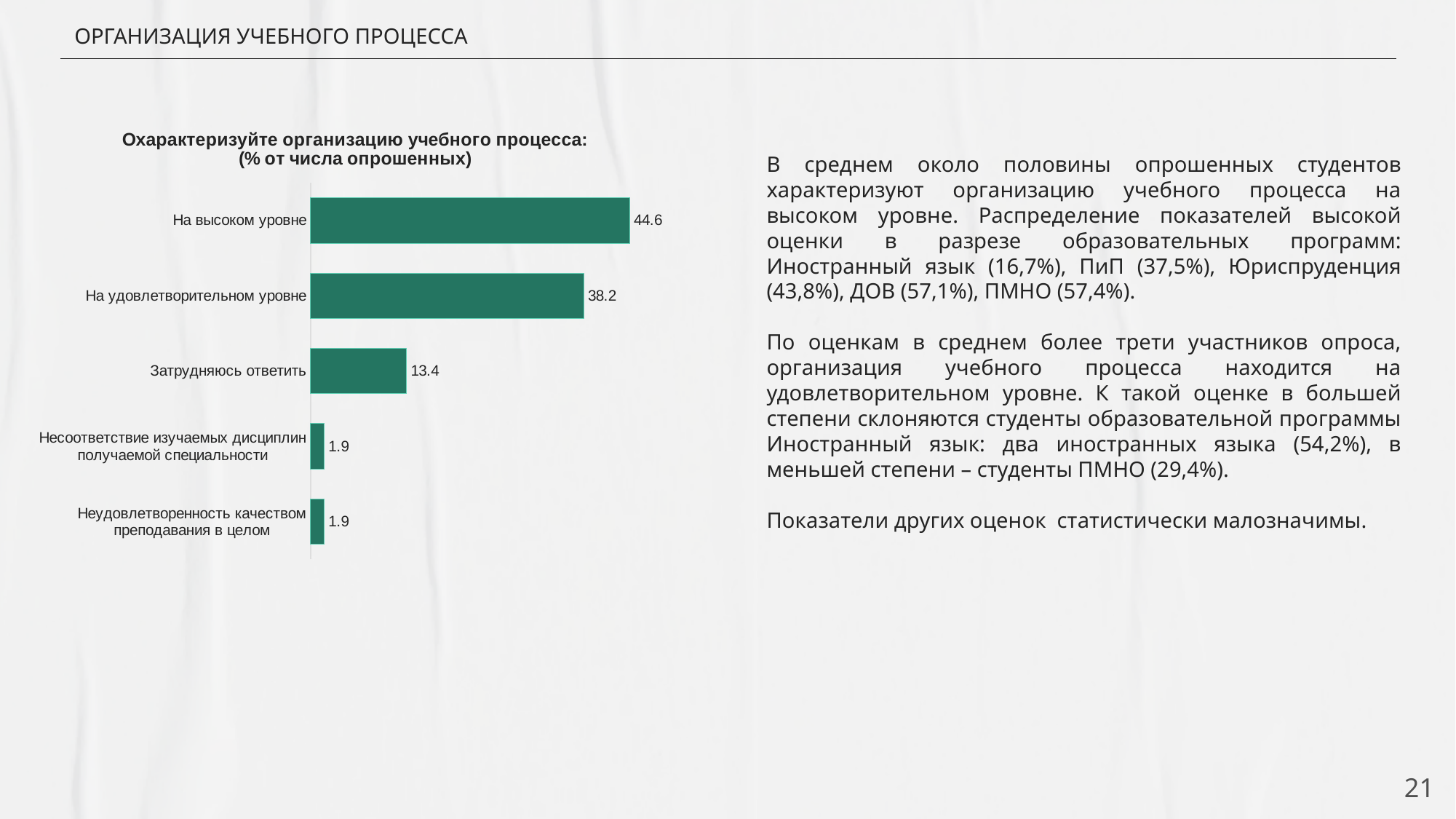
Which is larger: the value for "Затрудняюсь ответить" or the value for "Неудовлетворенность качеством преподавания в целом"? Затрудняюсь ответить What is the difference between the values for "На высоком уровне" and "На удовлетворительном уровне"? 6.4 How many categories are shown in the chart? 5 What is the value for "Несоответствие изучаемых дисциплин получаемой специальности"? 1.9 What is the value for "На удовлетворительном уровне"? 38.2 What is the value for "Затрудняюсь ответить"? 13.4 Which category has the highest value? На высоком уровне What colour are the bars in the chart? Green What is the difference between the values for "На удовлетворительном уровне" and "Затрудняюсь ответить"? 24.8 What is the value for "На высоком уровне"? 44.6 What kind of chart is shown on the slide? Bar chart What is the title of the chart? Охарактеризуйте организацию учебного процесса: (% от числа опрошенных)